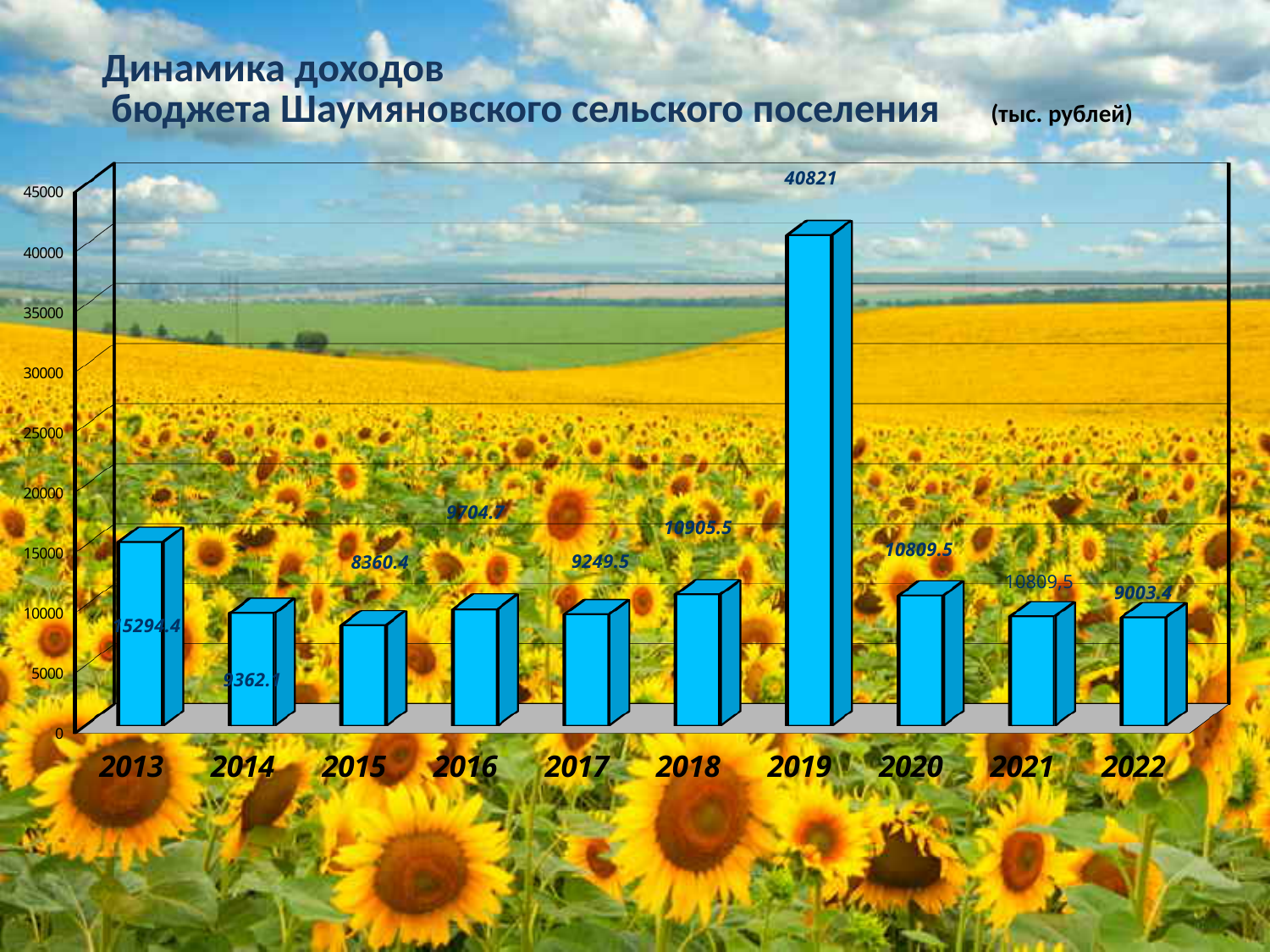
What is the value for 2019? 40821 Which year has the lowest value? 2015 What is the value for 2022? 9003.4 What is the difference between the values for 2020 and 2022? 1806.1 What is the value for 2018? 10905.5 What kind of chart is shown on the slide? bar chart How many years are shown on the x axis? 10 What is the value for 2015? 8360.4 Which year has the highest value? 2019 What is the difference between the values for 2019 and 2018? 29915.5 Is the value for 2013 greater or less than 10000? greater Which is larger, the value for 2016 or the value for 2017? 2016